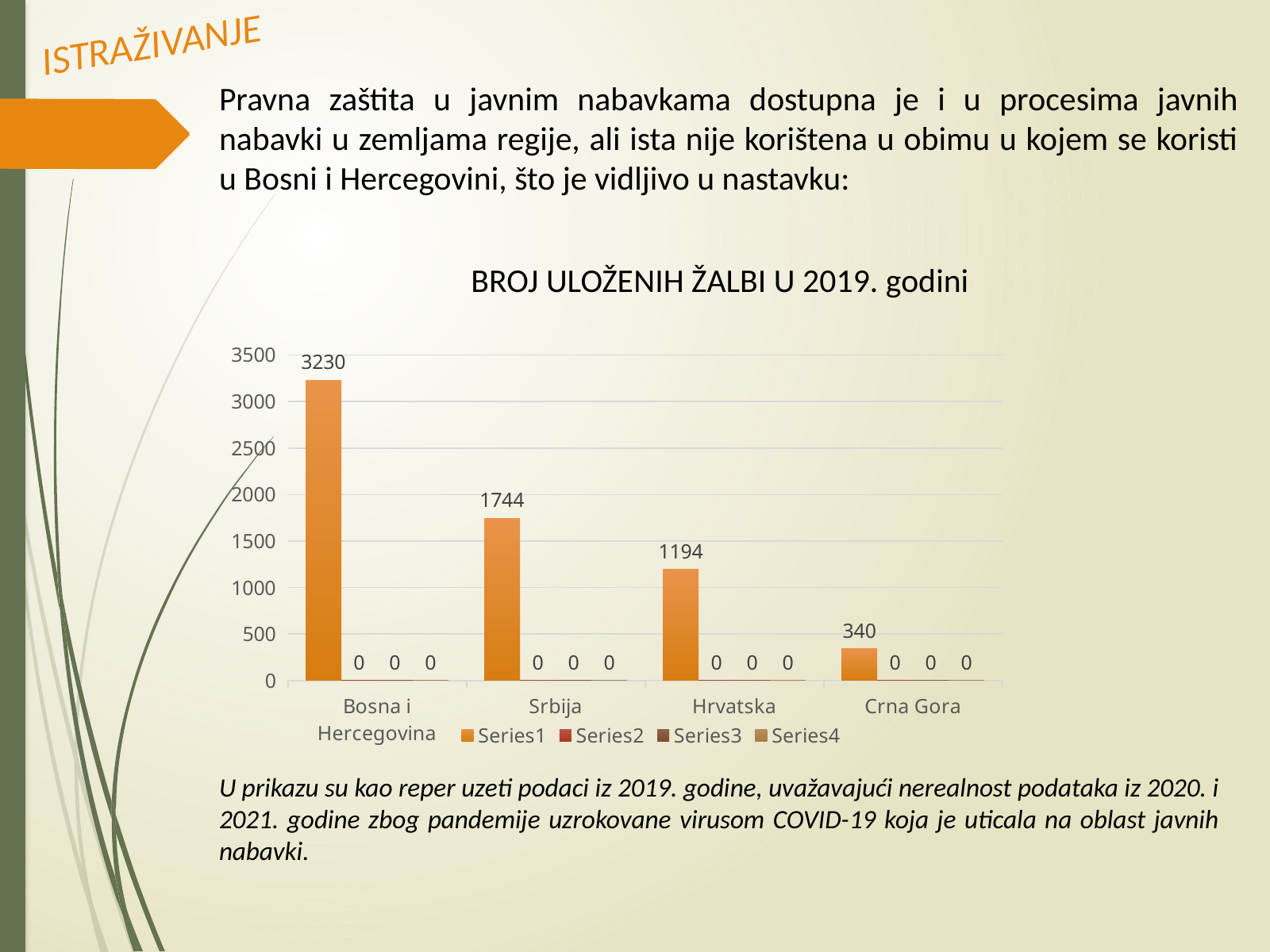
What is the value for Srbija in Series1? 1744 Which has a larger Series1 value, Hrvatska or Crna Gora? Hrvatska Which category has the highest Series1 value? Bosna i Hercegovina What is the difference between the Series1 values for Bosna i Hercegovina and Srbija? 1486 What is the value for Crna Gora in Series1? 340 What is the value for Hrvatska in Series1? 1194 How many series does the legend list? 4 How many categories are shown on the x axis? 4 Which category has the lowest Series1 value? Crna Gora What is the title of the chart? BROJ ULOŽENIH ŽALBI U 2019. godini What is the value for Bosna i Hercegovina in Series1? 3230 What kind of chart is shown on the slide? Bar chart